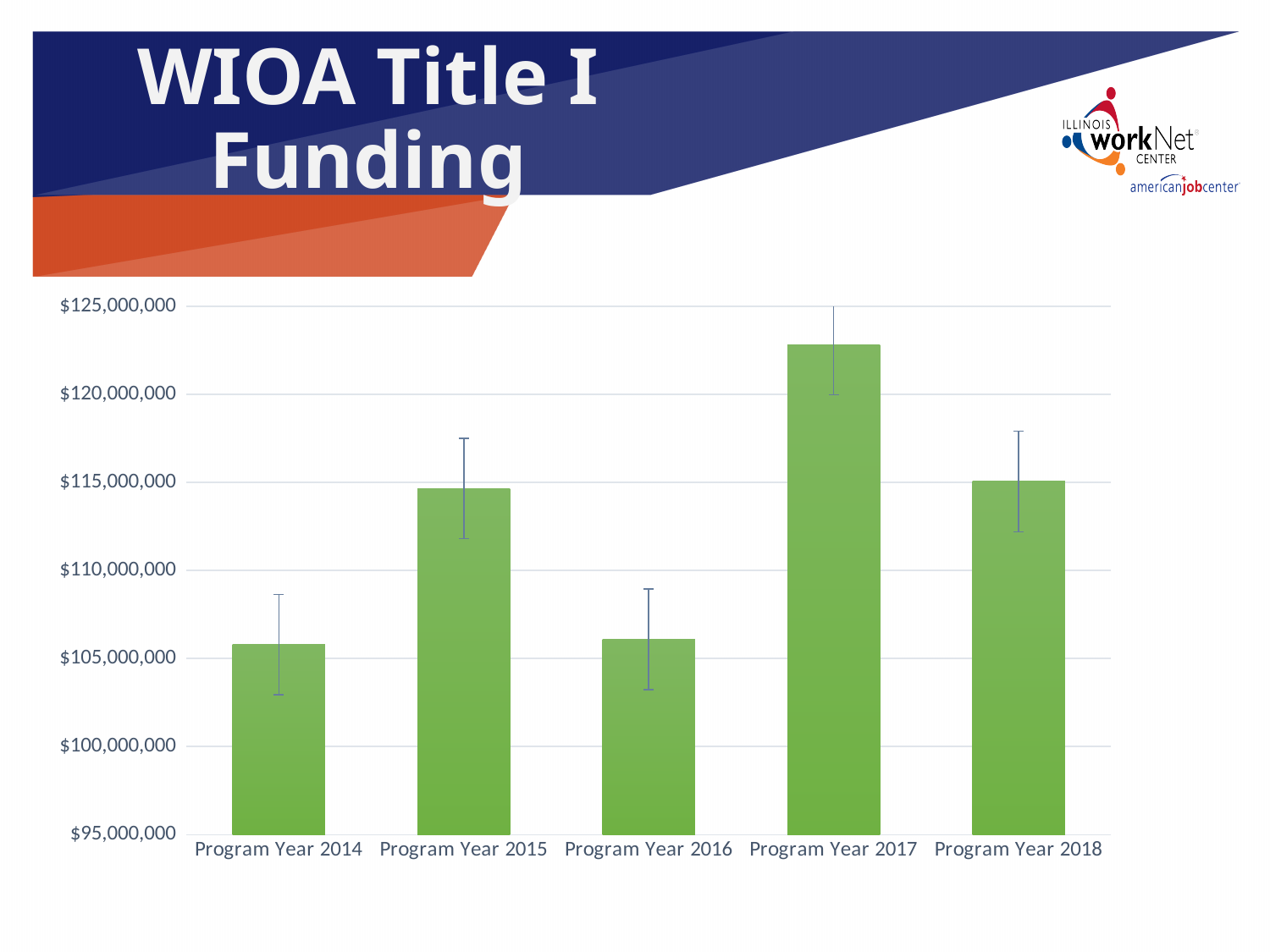
Which is larger, the funding for Program Year 2017 or Program Year 2015? Program Year 2017 Is the value for Program Year 2014 greater or less than $110,000,000? less Which is larger, the funding for Program Year 2015 or Program Year 2014? Program Year 2015 How many program years are plotted on the chart? 5 What kind of chart is shown on the slide? bar chart Does the funding rise or fall from Program Year 2016 to Program Year 2017? rise What is the title of the slide containing the chart? WIOA Title I Funding What colour are the bars in the chart? green Is the value for Program Year 2015 greater or less than $110,000,000? greater Which program year has the highest funding bar? Program Year 2017 Is the value for Program Year 2018 greater or less than $120,000,000? less